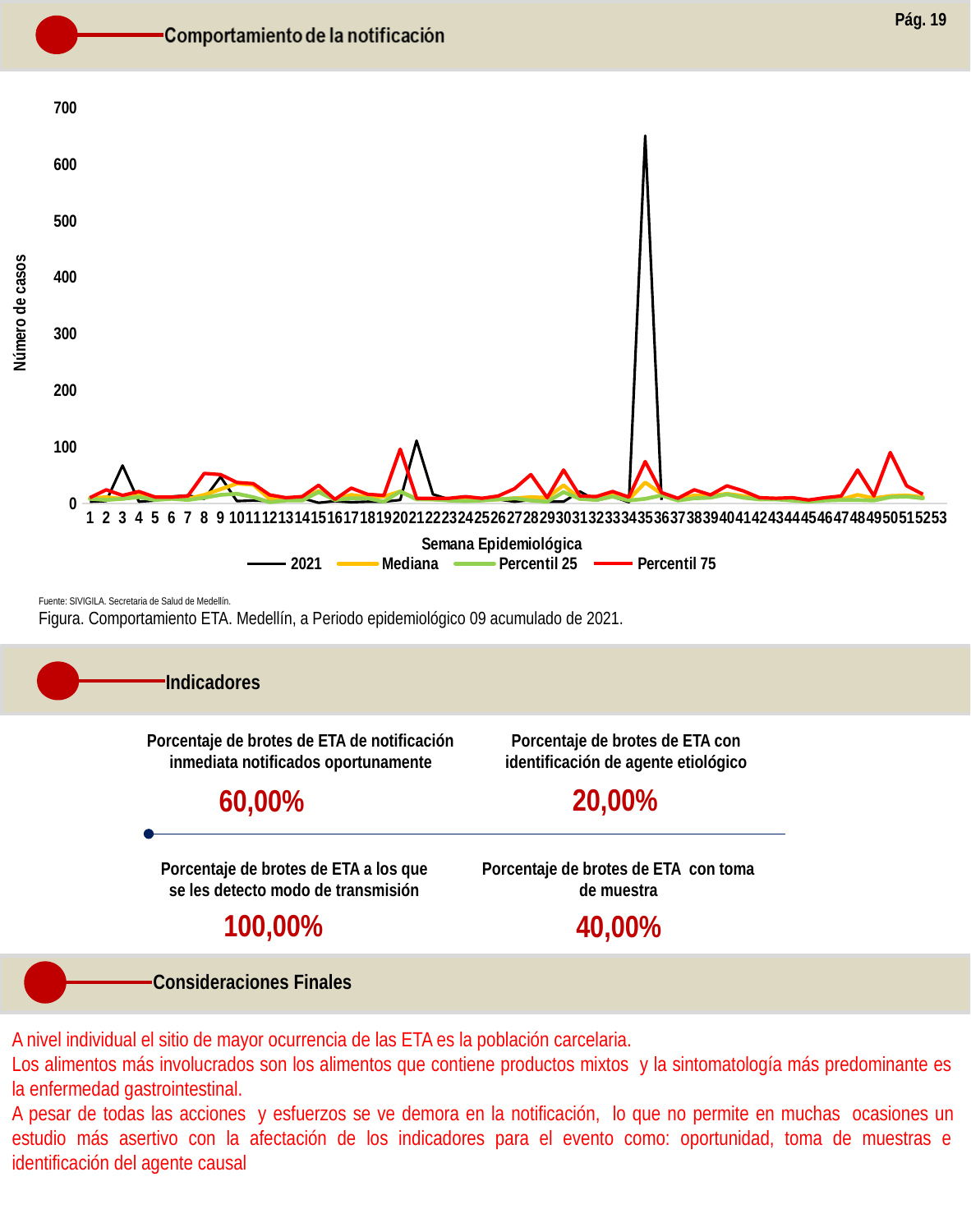
What is the title of the chart's x axis? Semana Epidemiológica Is the value of the Percentil 75 series in week 35 greater or less than 200? less Is the value of the 2021 series in week 35 greater or less than 600? greater Is the value of the 2021 series in week 35 greater or less than 500? greater How many series does the chart legend list? 4 In which epidemiological week does the 2021 series reach its highest value? 35 In week 35, which series has the larger value, 2021 or Percentil 75? 2021 What kind of chart is shown on the slide? line chart Which series are listed in the chart legend? 2021, Mediana, Percentil 25, Percentil 75 What is the highest tick value shown on the y axis (Número de casos)? 700 How many epidemiological weeks are shown along the x axis? 53